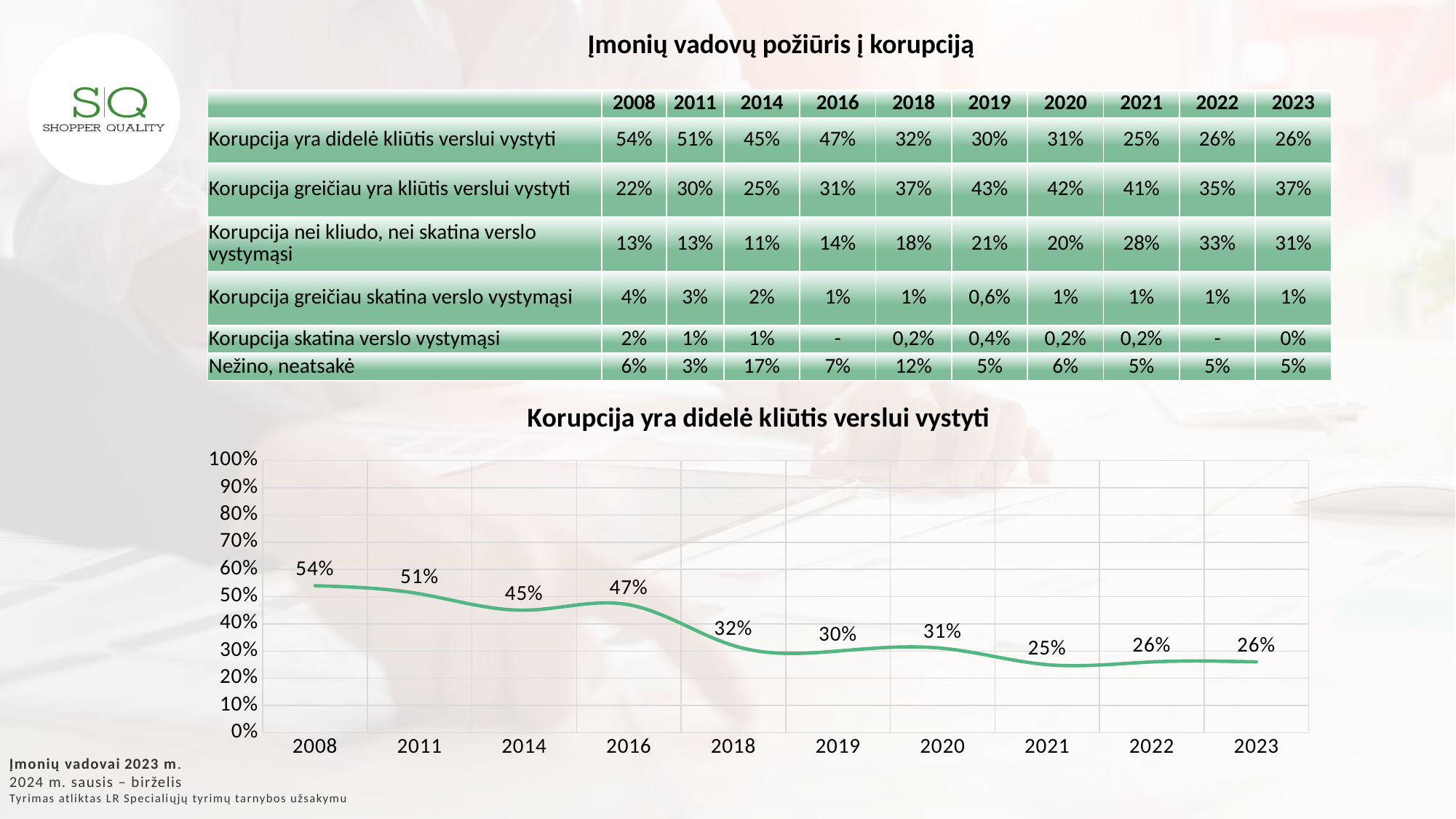
What is the title of the chart? Korupcija yra didelė kliūtis verslui vystyti What is the value for 2018 in the chart? 32% What is the value for 2023 in the chart? 26% Which is larger in the chart, the value for 2014 or the value for 2016? 2016 Which year has the lowest value in the chart? 2021 Is the value for 2011 in the chart greater or less than 50%? greater How many years are plotted on the x axis of the chart? 10 Which year has the highest value in the chart? 2008 What type of chart is shown on the slide? line chart Do the values in the chart generally rise or fall from 2008 to 2023? fall What is the difference between the values for 2008 and 2023 in the chart? 28% What is the value for 2008 in the chart? 54%